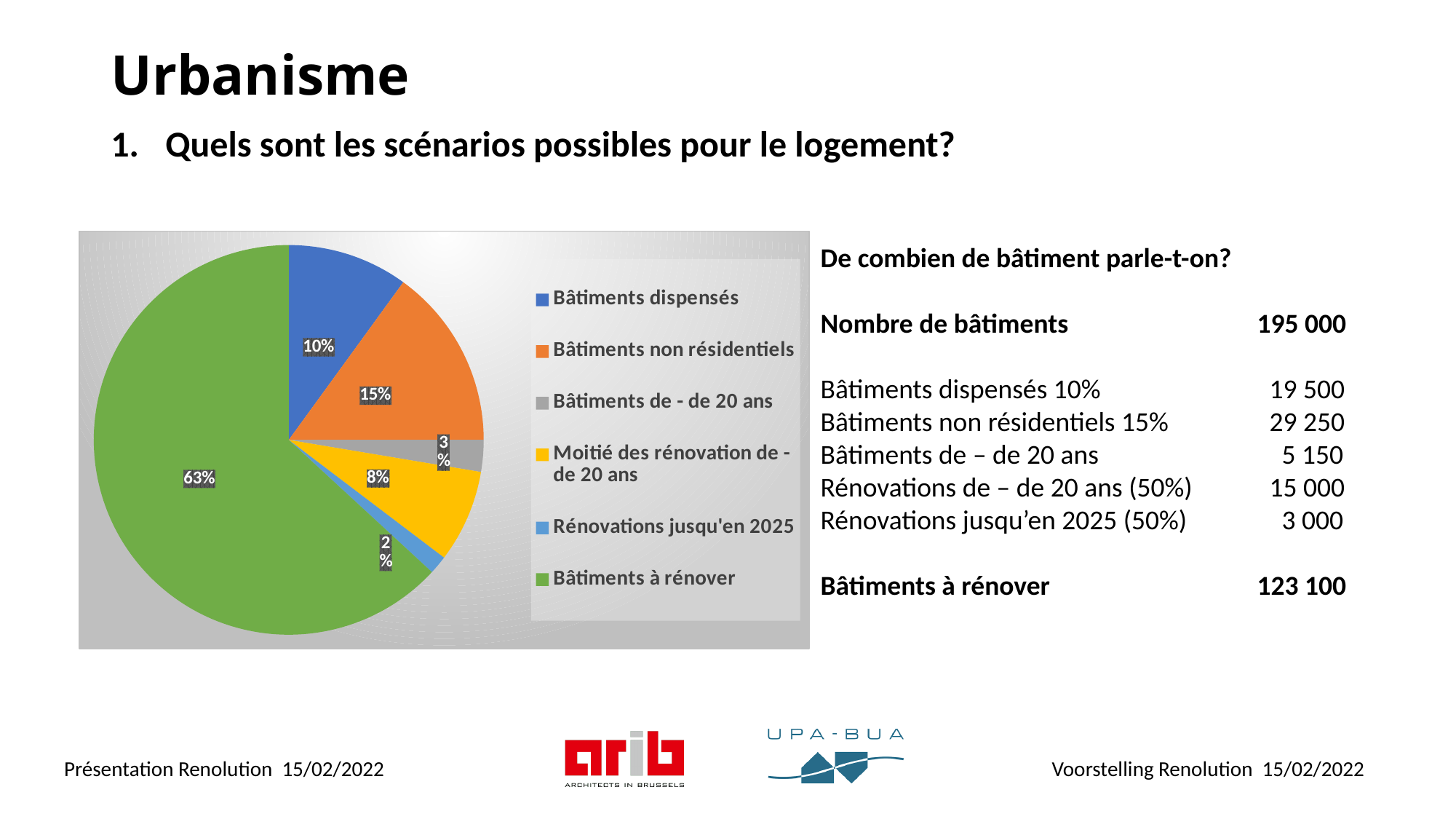
How many categories does the pie chart show? 6 What share of the pie does "Rénovations jusqu'en 2025" represent? 2% What share of the pie does "Bâtiments non résidentiels" represent? 15% Which category has the smallest slice of the pie? Rénovations jusqu'en 2025 Which is larger, the slice for "Bâtiments de - de 20 ans" or the slice for "Moitié des rénovation de - de 20 ans"? Moitié des rénovation de - de 20 ans What colour is the slice for "Bâtiments à rénover"? green Which category has the largest slice of the pie? Bâtiments à rénover What share of the pie does "Bâtiments à rénover" represent? 63% What kind of chart is shown on the slide? pie chart What share of the pie does "Bâtiments dispensés" represent? 10% What is the difference in percentage points between "Bâtiments non résidentiels" and "Bâtiments dispensés"? 5 What share of the pie does "Moitié des rénovation de - de 20 ans" represent? 8%